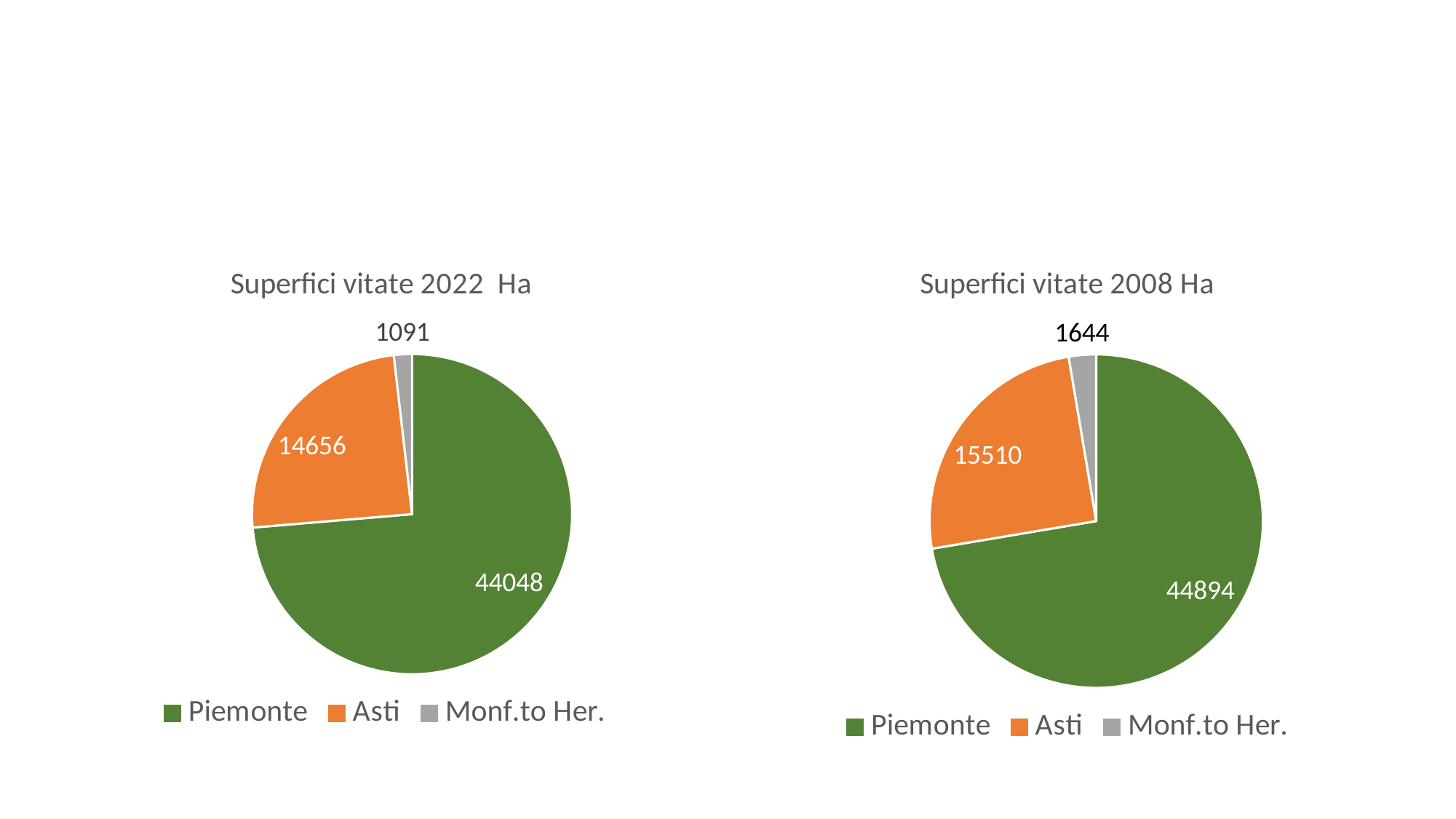
In the 'Superfici vitate 2022 Ha' chart, which category has the largest slice? Piemonte In the 'Superfici vitate 2008 Ha' chart, which category has the smallest slice? Monf.to Her. In the 'Superfici vitate 2022 Ha' chart, what is the value for Asti? 14656 What type of chart is the 'Superfici vitate 2008 Ha' chart? Pie chart In the 'Superfici vitate 2008 Ha' chart, what is the value for Asti? 15510 In the 'Superfici vitate 2022 Ha' chart, what is the value for Piemonte? 44048 In the 'Superfici vitate 2008 Ha' chart, what is the value for Piemonte? 44894 In the 'Superfici vitate 2022 Ha' chart, what is the difference between the values for Piemonte and Asti? 29392 How many categories does the legend of the 'Superfici vitate 2022 Ha' chart list? 3 In the 'Superfici vitate 2008 Ha' chart, what is the value for Monf.to Her.? 1644 In the 'Superfici vitate 2022 Ha' chart, what is the value for Monf.to Her.? 1091 Is the value for Asti larger in the 'Superfici vitate 2022 Ha' chart or in the 'Superfici vitate 2008 Ha' chart? Superfici vitate 2008 Ha